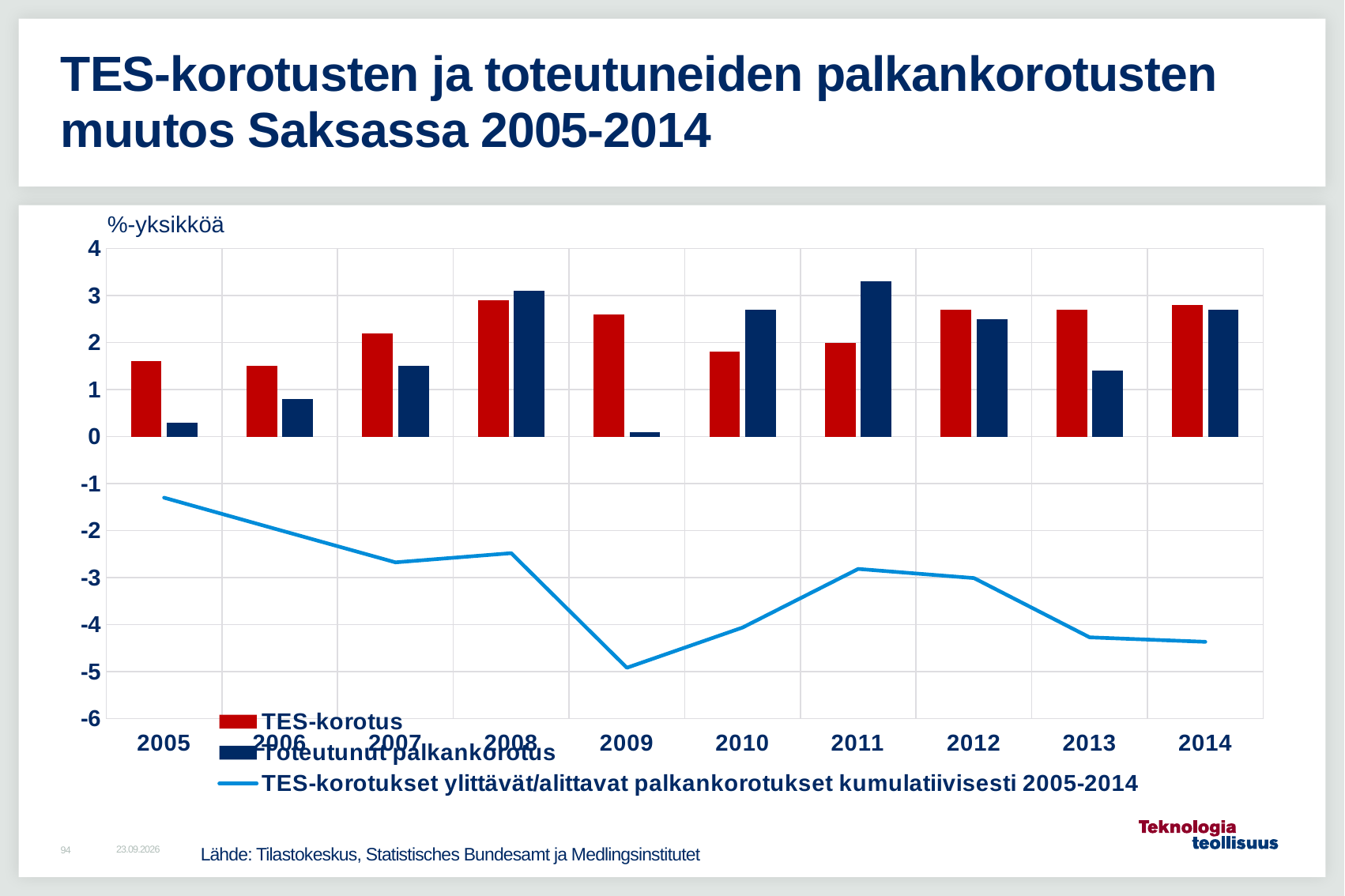
In 2009, which is larger: TES-korotus or Toteutunut palkankorotus? TES-korotus Is the Toteutunut palkankorotus value for 2011 greater or less than 3? greater What unit label is shown above the vertical axis of the chart? %-yksikköä Is the Toteutunut palkankorotus value for 2009 greater or less than 1? less Is the TES-korotus value for 2005 greater or less than 1? greater How many series does the chart's legend list? 3 In 2011, which is larger: TES-korotus or Toteutunut palkankorotus? Toteutunut palkankorotus How many years are shown on the x axis of the chart? 10 In which year is the Toteutunut palkankorotus bar the lowest? 2009 In which year is the Toteutunut palkankorotus bar the highest? 2011 In which year does the cumulative line (TES-korotukset ylittävät/alittavat palkankorotukset kumulatiivisesti 2005-2014) reach its lowest point? 2009 What kind of chart is shown on the slide? A combined bar and line chart